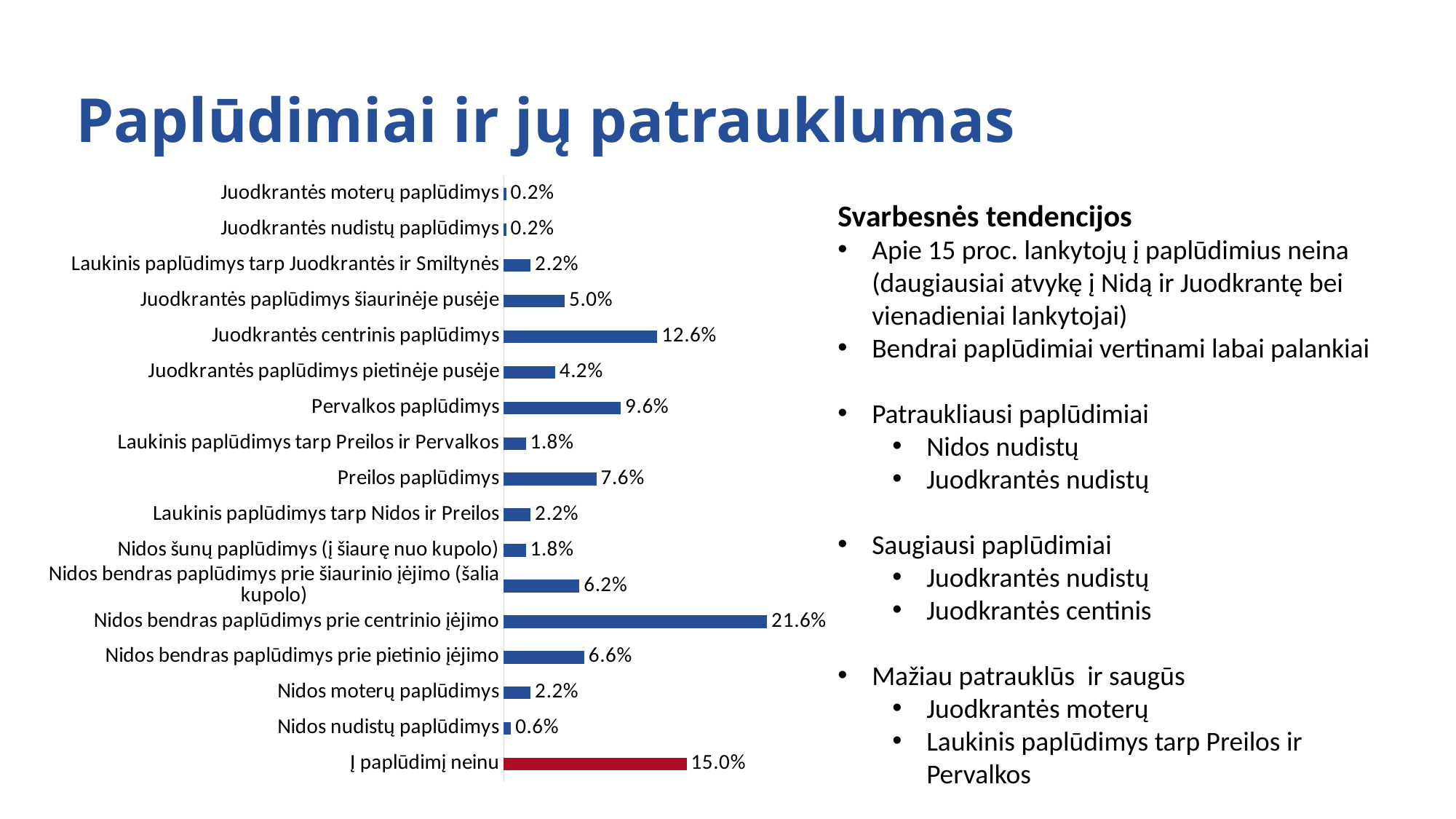
How many categories are shown in the chart? 17 Which is larger, the value for Preilos paplūdimys or the value for Nidos bendras paplūdimys prie pietinio įėjimo? Preilos paplūdimys Which category's bar is coloured red instead of blue? Į paplūdimį neinu What is the value for Į paplūdimį neinu? 15.0% What is the value for Juodkrantės centrinis paplūdimys? 12.6% Which category has the highest value? Nidos bendras paplūdimys prie centrinio įėjimo What kind of chart is shown on the slide? bar chart What is the difference between the values for Nidos bendras paplūdimys prie centrinio įėjimo and Į paplūdimį neinu? 6.6% What is the value for Pervalkos paplūdimys? 9.6% What is the difference between the values for Juodkrantės centrinis paplūdimys and Pervalkos paplūdimys? 3.0% What is the value for Nidos bendras paplūdimys prie centrinio įėjimo? 21.6% What is the value for Nidos nudistų paplūdimys? 0.6%